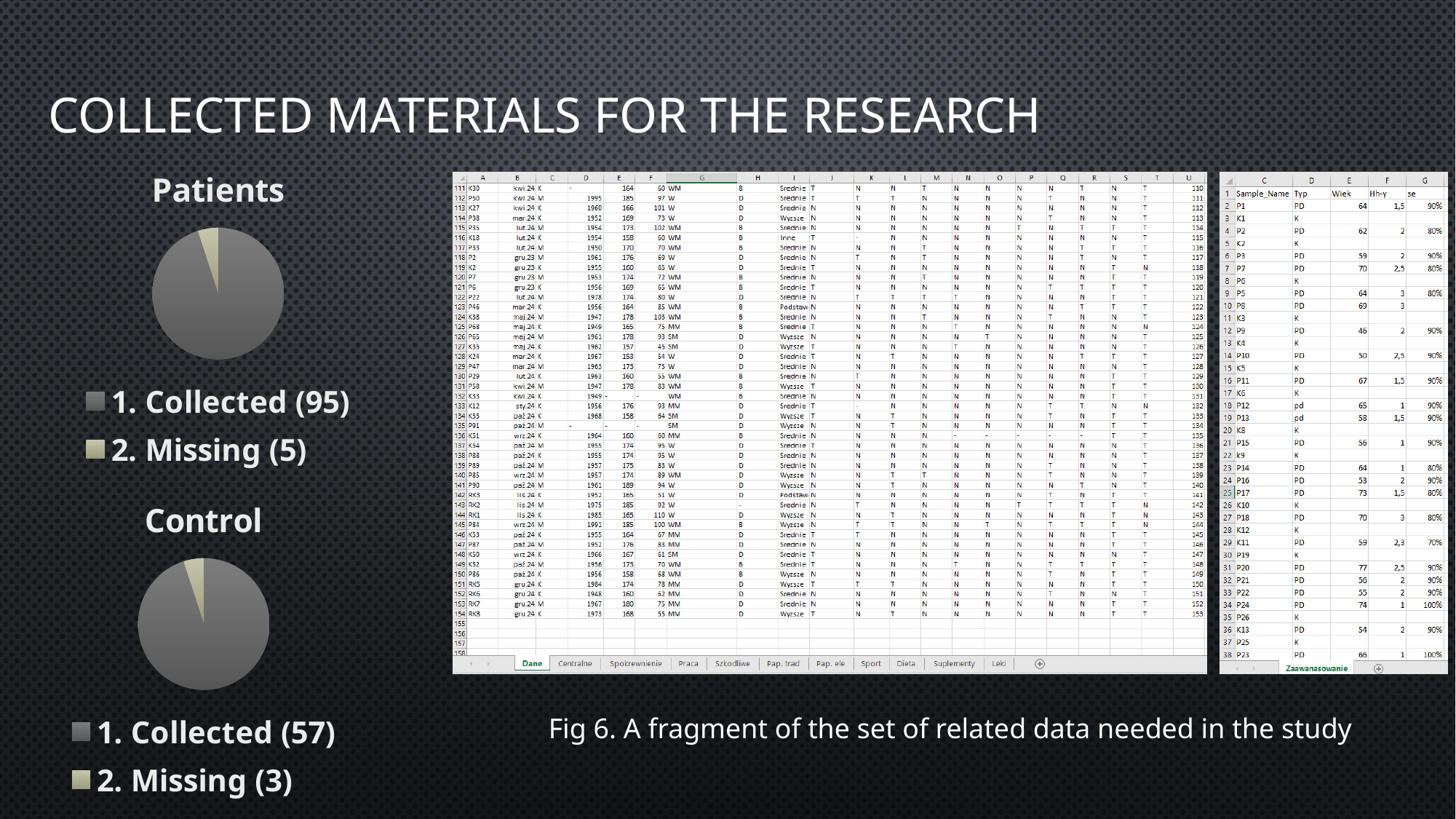
What type of chart is the "Patients" chart? pie chart In the "Control" chart, what is the difference between the collected and missing counts? 54 In the "Patients" chart, what share of the total does the "1. Collected" slice represent? 95% In the "Control" chart, how many samples were collected? 57 In the "Patients" chart, what is the difference between the collected and missing counts? 90 In the "Patients" chart, which category is the largest? 1. Collected In the "Control" chart, how many samples are missing? 3 In the "Control" chart, which category is the smallest? 2. Missing In the "Patients" chart, how many samples are missing? 5 In the "Patients" chart, how many samples were collected? 95 Which is larger: the number collected in the "Patients" chart or the number collected in the "Control" chart? Patients How many categories does the "Control" chart's legend list? 2